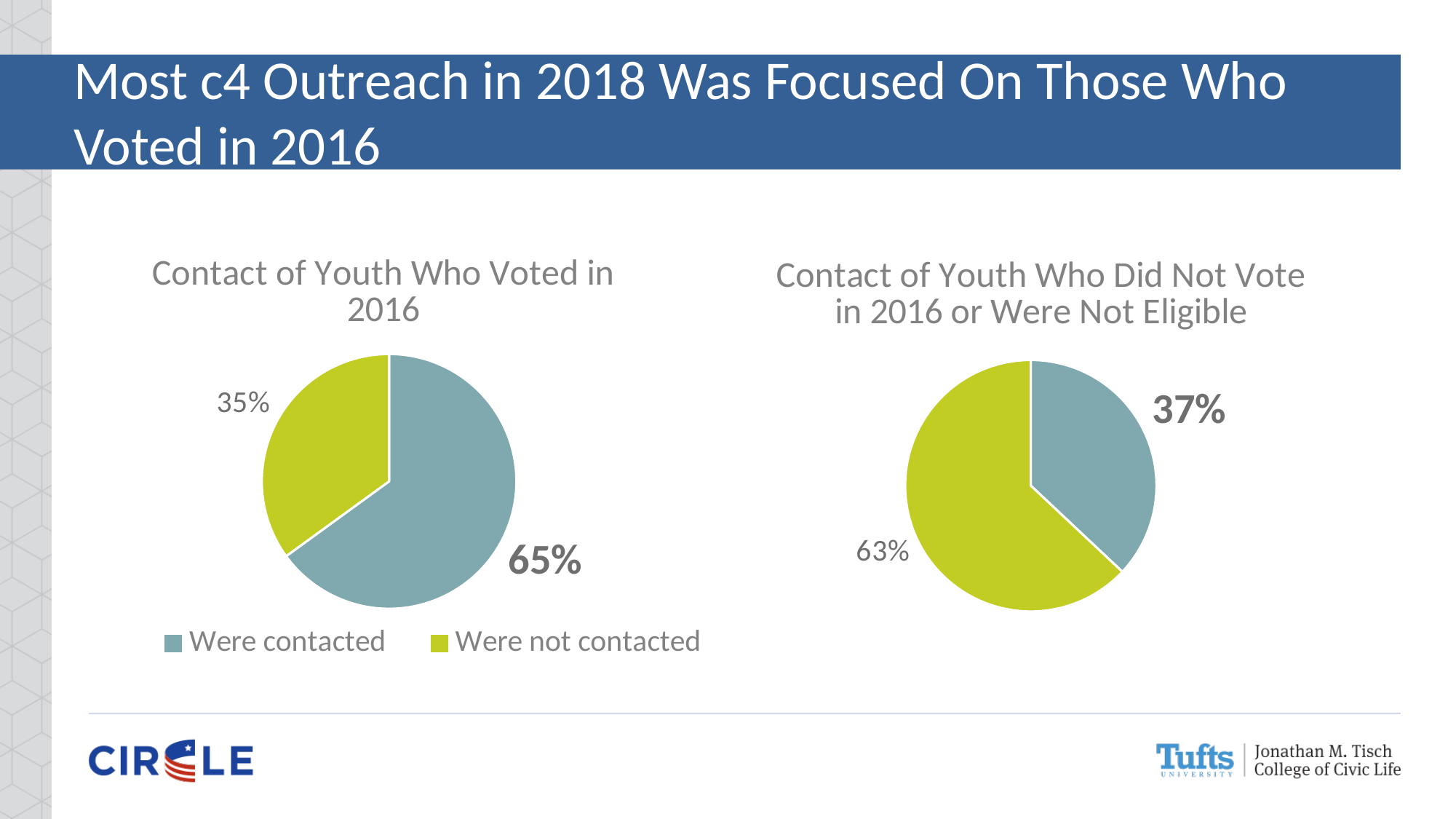
In the 'Contact of Youth Who Did Not Vote in 2016 or Were Not Eligible' chart, what is the difference between the not contacted and contacted shares? 26% In the 'Contact of Youth Who Voted in 2016' chart, what percentage were not contacted? 35% What type of chart is used on this slide? Pie chart In the 'Contact of Youth Who Did Not Vote in 2016 or Were Not Eligible' chart, which slice is the smallest? Were contacted In the 'Contact of Youth Who Voted in 2016' chart, what percentage were contacted? 65% In the 'Contact of Youth Who Voted in 2016' chart, which slice is the largest? Were contacted How many series does the legend list? 2 In the 'Contact of Youth Who Voted in 2016' chart, what is the difference between the contacted and not contacted shares? 30% Which chart shows a larger share of youth who were contacted: the left chart or the right chart? The left chart Which colour represents 'Were not contacted' in the legend? Yellow-green In the 'Contact of Youth Who Did Not Vote in 2016 or Were Not Eligible' chart, what percentage were not contacted? 63% In the 'Contact of Youth Who Did Not Vote in 2016 or Were Not Eligible' chart, what percentage were contacted? 37%